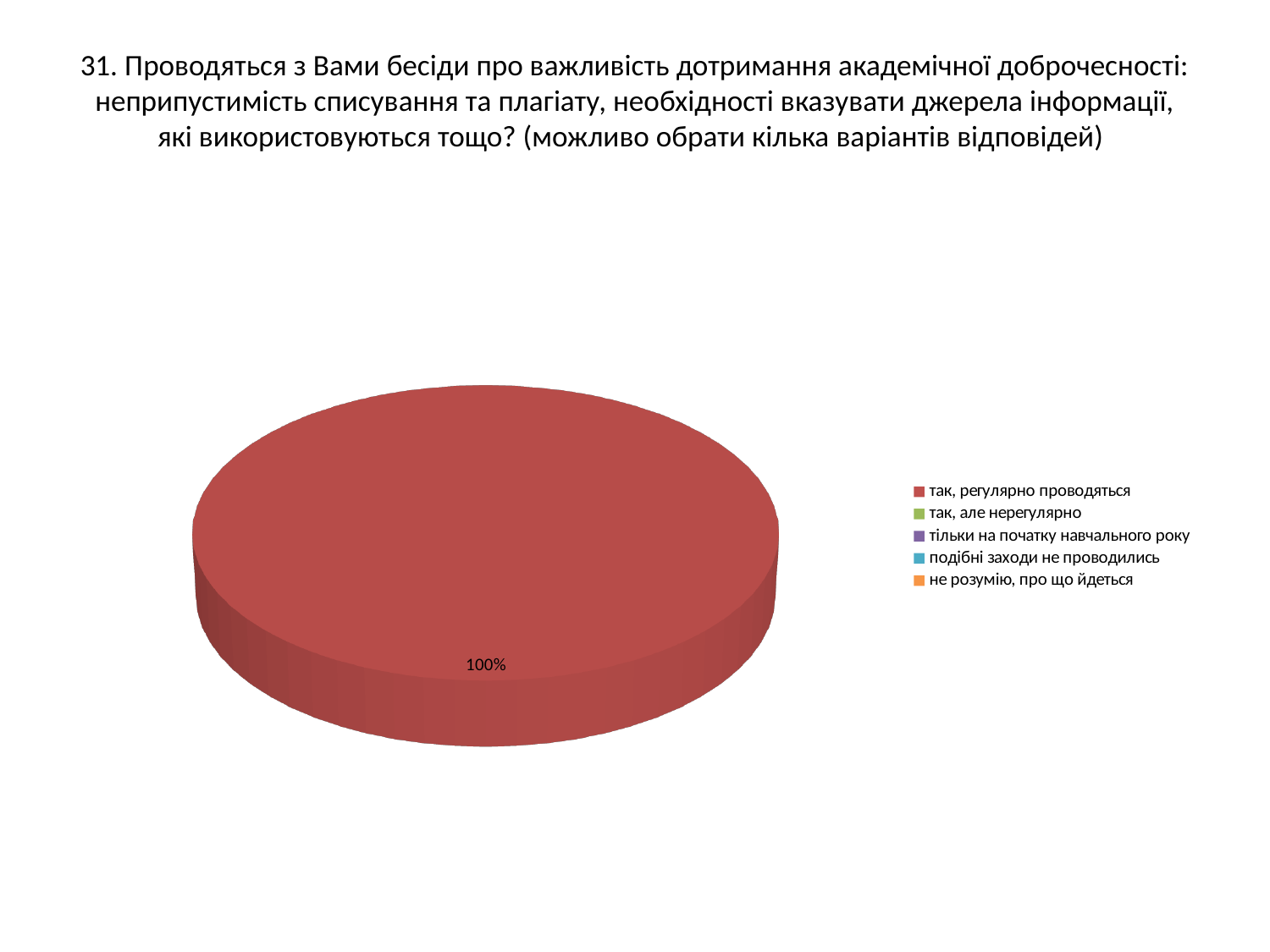
How many slices are visible in the pie chart? 1 What colour is the slice for "так, регулярно проводяться" in the pie chart? red What kind of chart is shown on the slide? pie chart Is the share for "так, регулярно проводяться" greater or less than 50%? greater How many categories does the legend of the pie chart list? 5 What share of the pie does the slice for "так, регулярно проводяться" represent? 100% Which legend entry is listed last in the pie chart's legend? не розумію, про що йдеться Which category has the largest share in the pie chart? так, регулярно проводяться What value is printed on the only visible slice of the pie chart? 100%